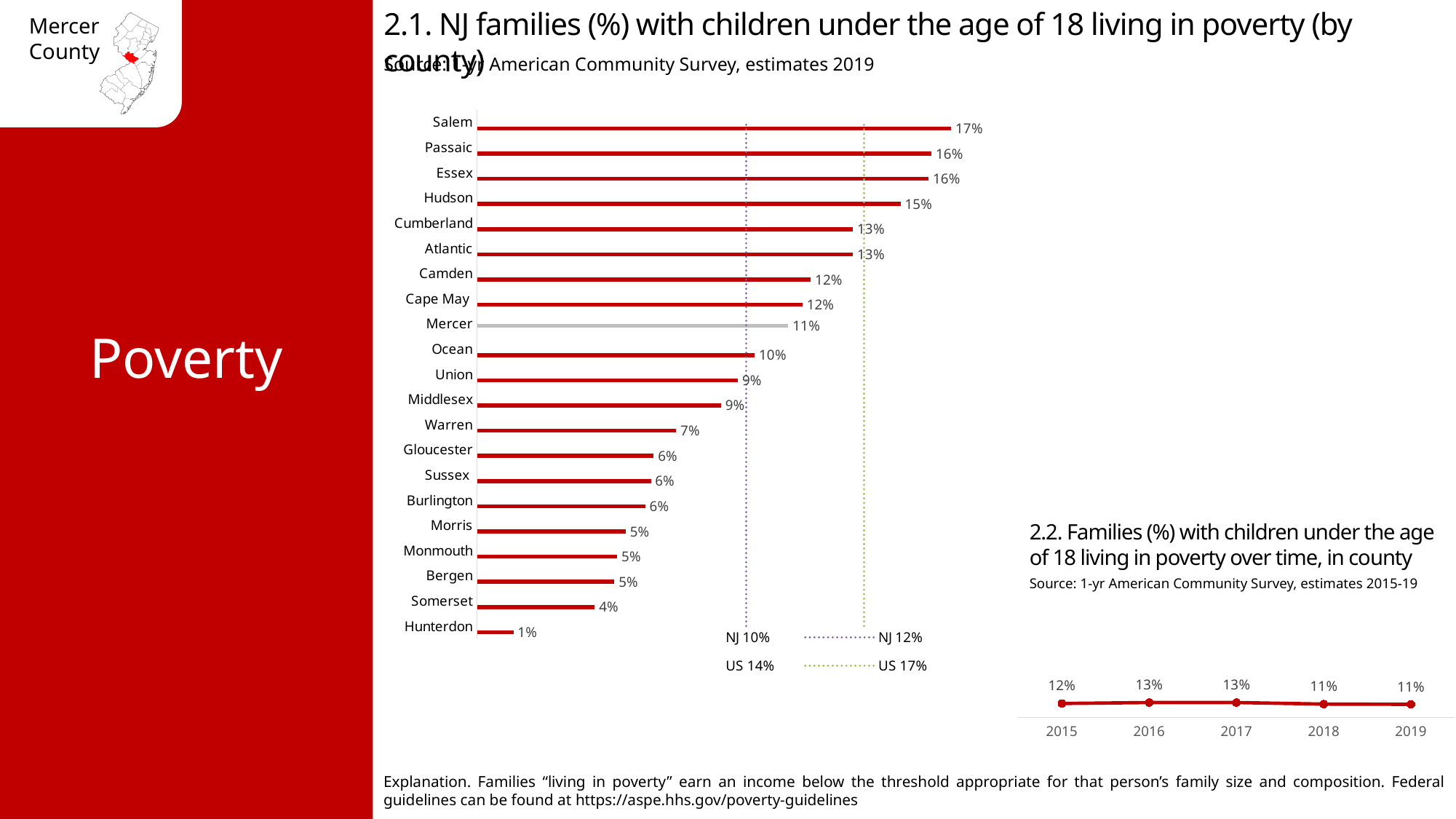
In chart 2.1 (poverty by county), which county has the highest value? Salem In chart 2.1 (poverty by county), what is the value for Somerset? 4% In chart 2.1 (NJ families with children under 18 living in poverty by county), what is the value for Mercer? 11% In chart 2.2 (families in poverty over time in county), how many years are plotted? 5 How many counties are shown in chart 2.1 (poverty by county)? 21 What type of chart is chart 2.1 (poverty by county)? Bar chart In chart 2.1 (poverty by county), which is larger, the value for Hudson or the value for Camden? Hudson In chart 2.1 (poverty by county), what is the difference between Salem and Mercer? 6 percentage points In chart 2.2 (families in poverty over time in county), what is the difference between the 2016 value and the 2019 value? 2 percentage points In chart 2.2 (families in poverty over time in county), what is the value for 2017? 13% In chart 2.1 (poverty by county), which county has the lowest value? Hunterdon